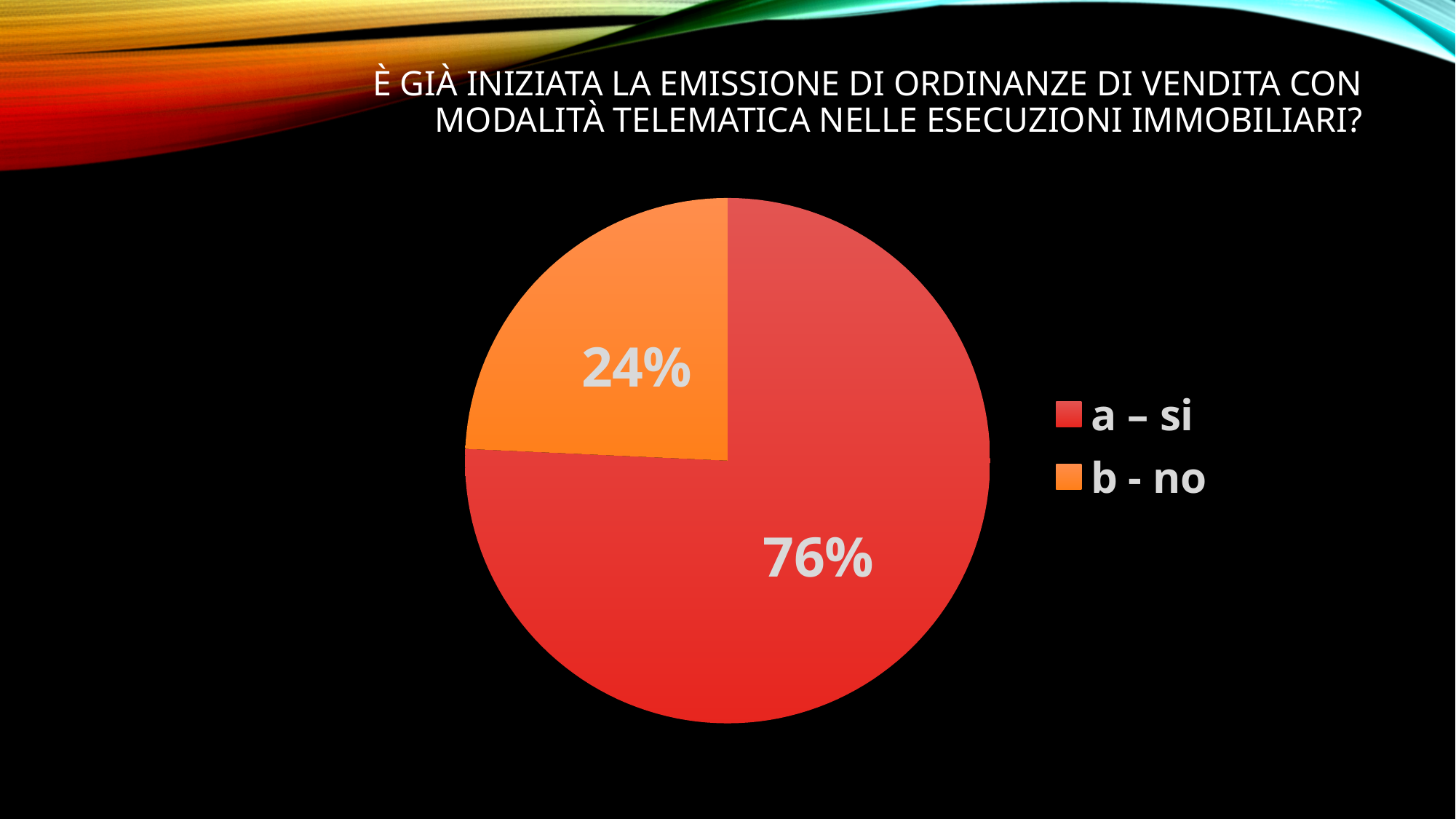
What colour is the "a – si" slice? red What share of the pie does the "b - no" slice represent? 24% How many entries does the legend list? 2 What percentage is shown for the slice labelled "a – si"? 76% What is the difference in percentage points between the "a – si" slice and the "b - no" slice? 52 Which slice of the pie is the largest? a – si What kind of chart is shown on the slide? pie chart How many slices does the pie chart have? 2 Which is larger, the "a – si" slice or the "b - no" slice? a – si What percentage is shown for the slice labelled "b - no"? 24% What colour is the "b - no" slice? orange Which slice of the pie is the smallest? b - no